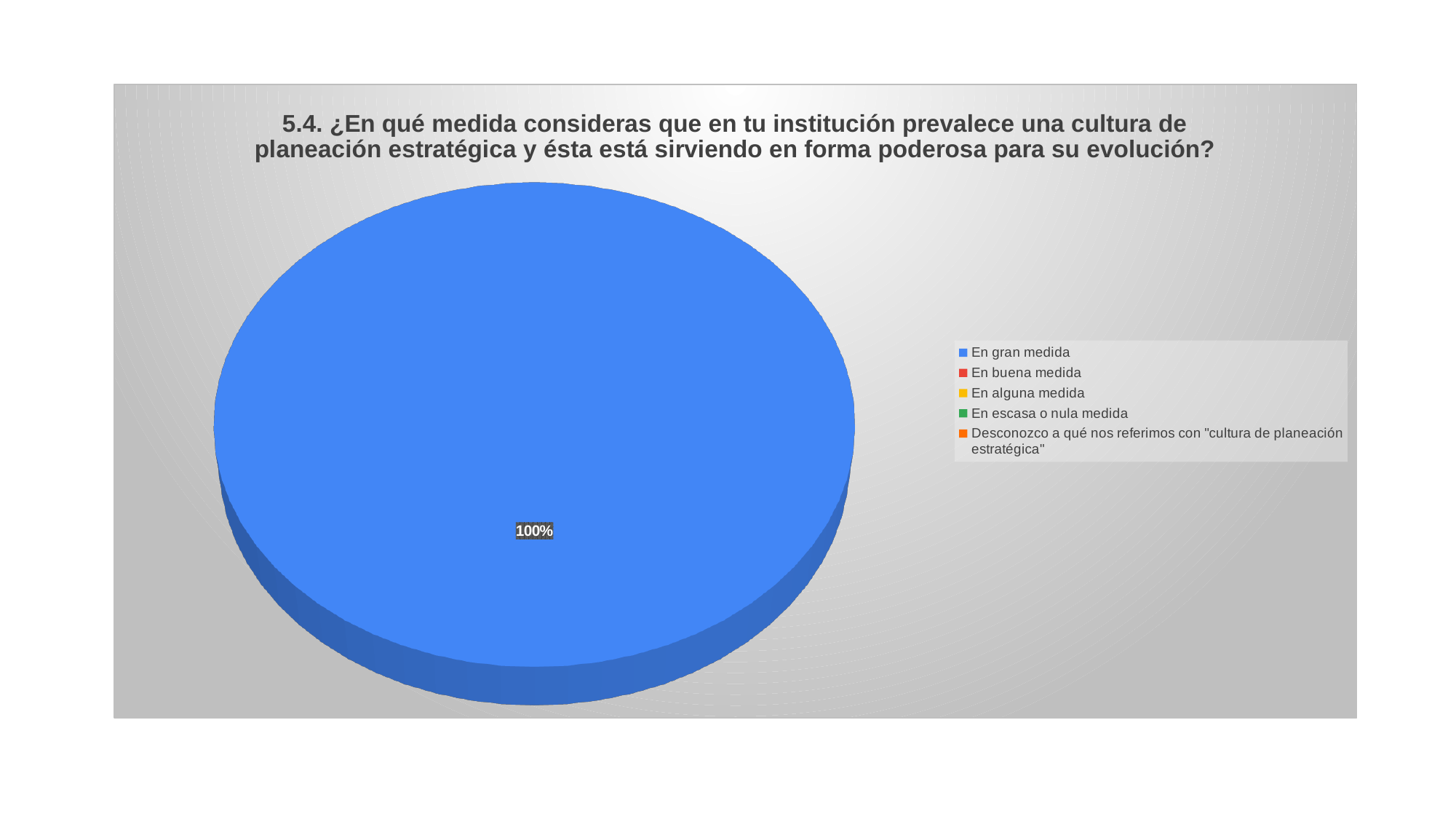
Which legend entry is listed last? Desconozco a qué nos referimos con "cultura de planeación estratégica" What share of the pie does "En gran medida" hold? 100% What is the data label printed on the pie slice? 100% What colour is the slice for "En gran medida"? blue How many slices are visible in the pie? 1 How many entries does the legend list? 5 Which category accounts for the entire pie? En gran medida What kind of chart is shown on the slide? pie chart Is the share for "En gran medida" greater or less than 50%? greater